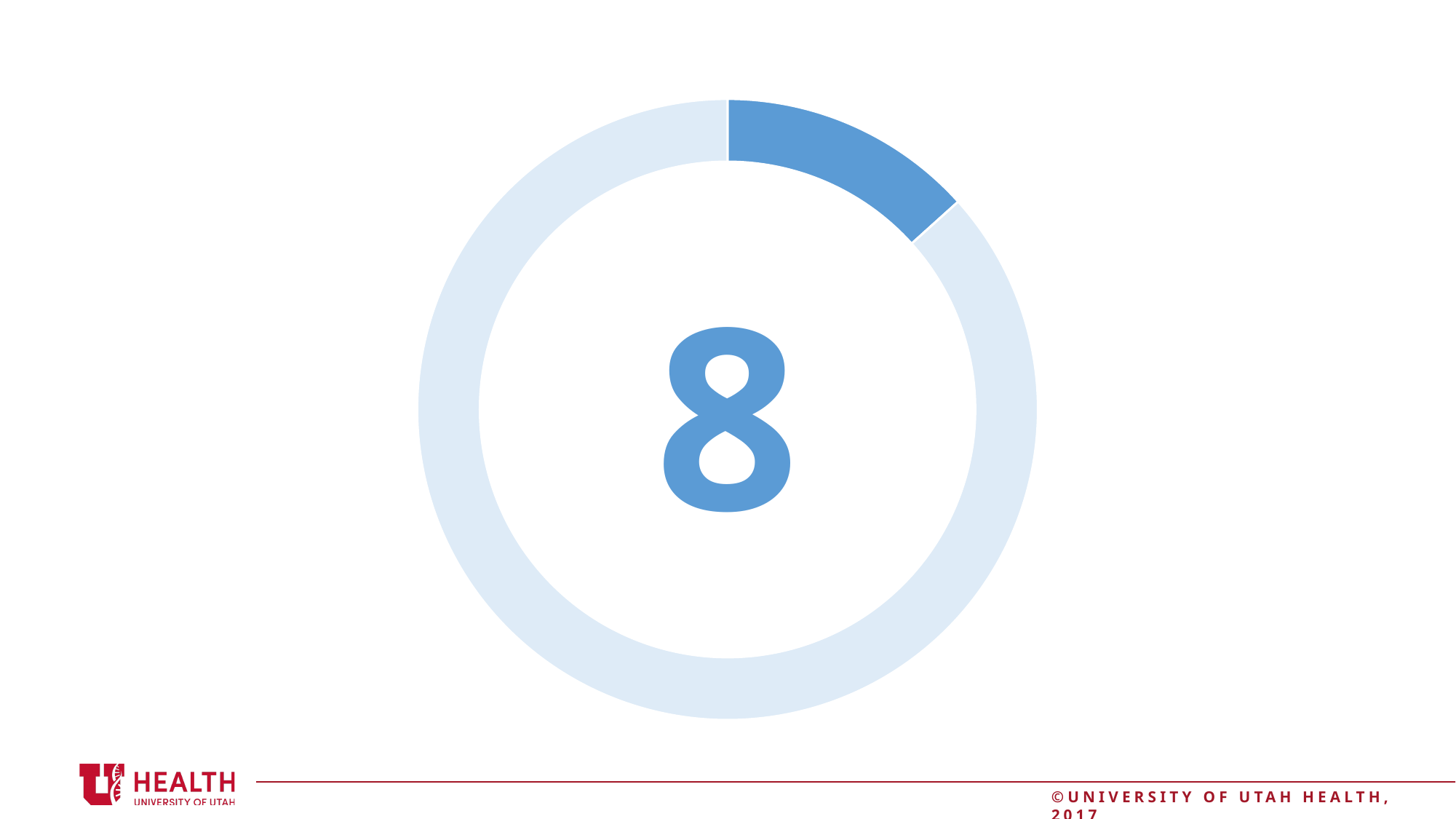
Which segment of the doughnut is larger, the dark blue one or the light blue one? light blue What colour is the number in the centre of the doughnut chart? blue What kind of chart is shown on the slide? doughnut chart What number is displayed in the centre of the doughnut chart? 8 Does the doughnut chart have a legend? No How many segments does the doughnut ring have? 2 Which segment of the doughnut is smaller, the dark blue one or the light blue one? dark blue